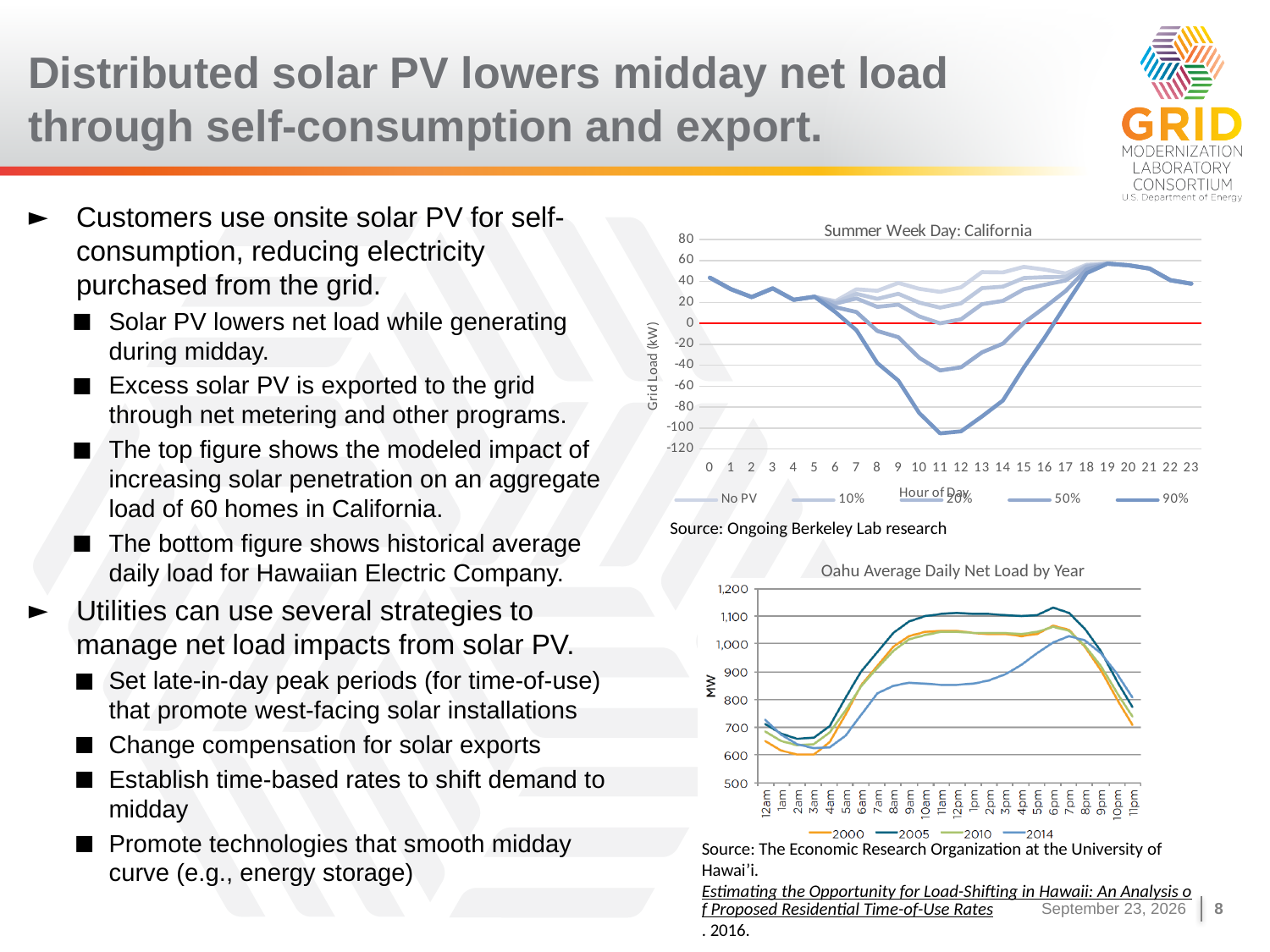
What type of chart is the 'Summer Week Day: California' chart? line chart In the 'Oahu Average Daily Net Load by Year' chart, which series has the lowest value at 11am? 2014 In the 'Summer Week Day: California' chart, what is the y-axis label? Grid Load (kW) In the 'Summer Week Day: California' chart, which series has the lowest value at hour 11? 90% In the 'Oahu Average Daily Net Load by Year' chart, does the 2014 series rise or fall from 12am to 6pm? rise What type of chart is the 'Oahu Average Daily Net Load by Year' chart? line chart In the 'Summer Week Day: California' chart, is the value of the 50% series at hour 11 greater or less than -20? less How many series does the legend of the 'Oahu Average Daily Net Load by Year' chart list? 4 In the 'Oahu Average Daily Net Load by Year' chart, is the value of the 2014 series at 11am greater or less than 900? less How many series does the legend of the 'Summer Week Day: California' chart list? 5 In the 'Summer Week Day: California' chart, is the value of the 90% series at hour 11 greater or less than -80? less In the 'Summer Week Day: California' chart, how many hours are shown on the x axis? 24